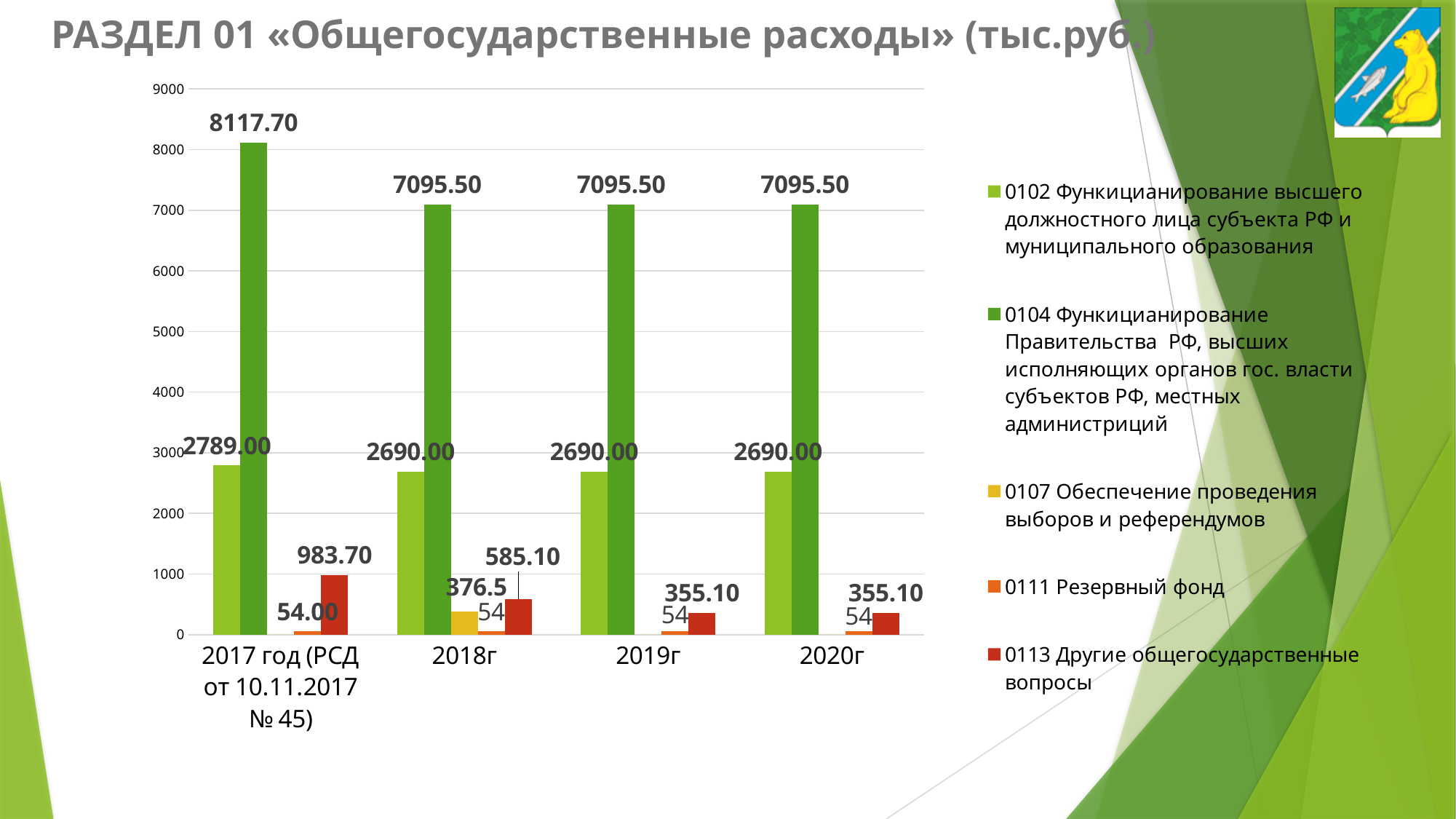
How many year categories are shown on the x axis? 4 How many series does the legend list? 5 What kind of chart is shown on the slide? bar chart What is the value for series 0102 in 2020? 2690.00 What is the value for series 0107 in 2018? 376.5 Which series is shown in dark green in the legend? 0104 Функицианирование Правительства РФ, высших исполняющих органов гос. власти субъектов РФ, местных администриций What is the difference between the 0104 value in 2017 and in 2018? 1022.20 What is the value for series 0113 in 2018? 585.10 Which is larger in 2019: the value for series 0102 or series 0113? 0102 What is the value for series 0104 in 2017? 8117.70 In which year is the value for series 0104 highest? 2017 Does the value for series 0104 in 2018 rise or fall compared with 2017? fall